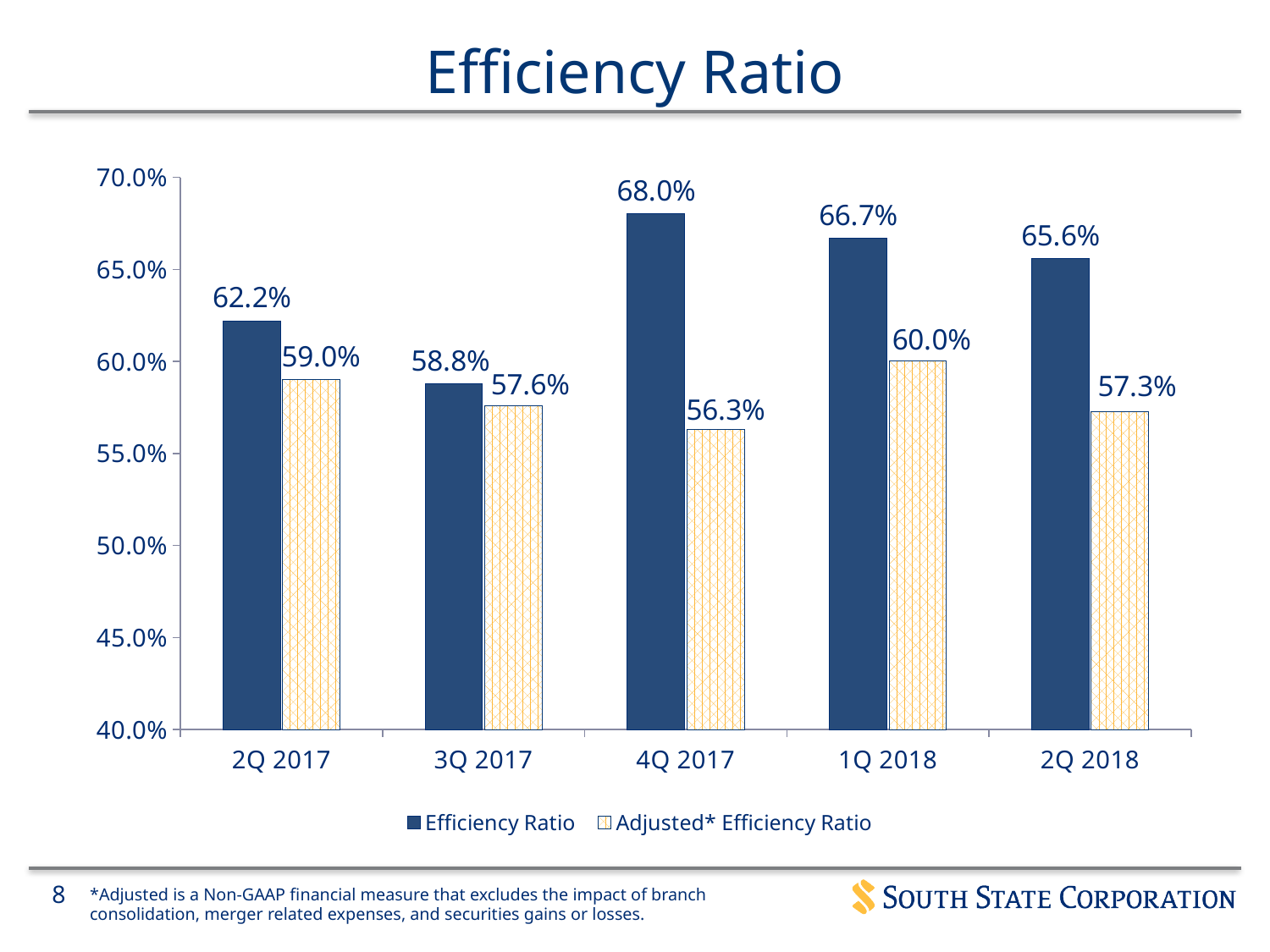
What is the difference between the Efficiency Ratio and the Adjusted* Efficiency Ratio in 4Q 2017? 11.7% What is the Efficiency Ratio for 4Q 2017? 68.0% How many quarters are shown on the x axis? 5 What kind of chart is shown on the slide? bar chart What is the Adjusted* Efficiency Ratio for 1Q 2018? 60.0% Which quarter has the lowest Adjusted* Efficiency Ratio? 4Q 2017 How many series does the legend list? 2 Which quarter has the highest Efficiency Ratio? 4Q 2017 Does the Efficiency Ratio rise or fall from 4Q 2017 to 2Q 2018? fall Which is larger: the Efficiency Ratio in 2Q 2017 or in 2Q 2018? 2Q 2018 Is the Efficiency Ratio for 3Q 2017 greater or less than 60.0%? less What is the Adjusted* Efficiency Ratio for 2Q 2018? 57.3%